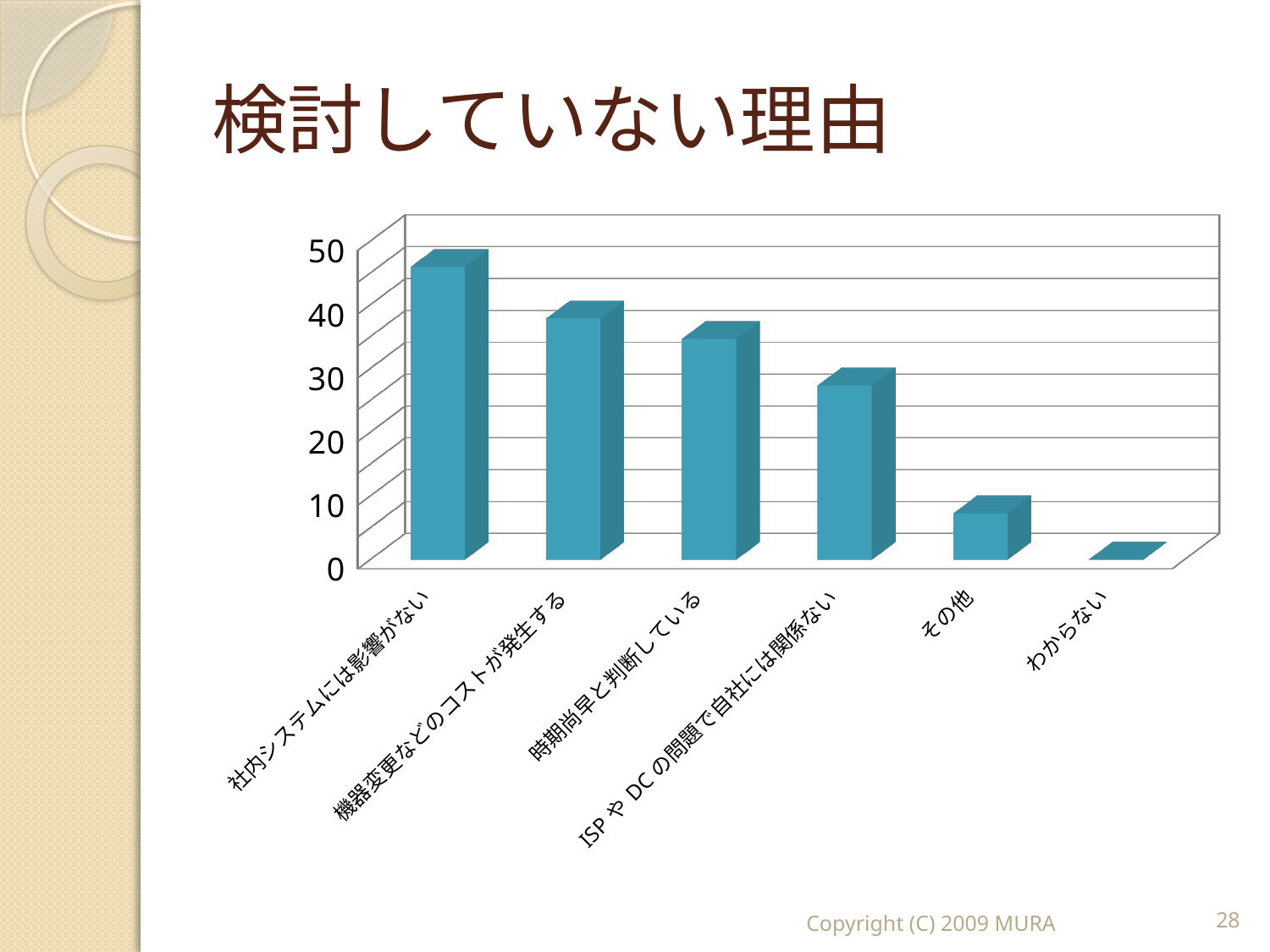
Which is larger, the value for 時期尚早と判断している or the value for ISPやDCの問題で自社には関係ない? 時期尚早と判断している Is the value for ISPやDCの問題で自社には関係ない greater or less than 20? greater What kind of chart is shown on the slide? bar chart What is the title of the chart on the slide? 検討していない理由 Is the value for その他 greater or less than 10? less Do the values rise or fall from left to right along the x axis? fall Is the value for 機器変更などのコストが発生する greater or less than 30? greater Which category has the lowest value in the chart? わからない How many categories are shown on the x axis of the chart? 6 Which category has the highest value in the chart? 社内システムには影響がない